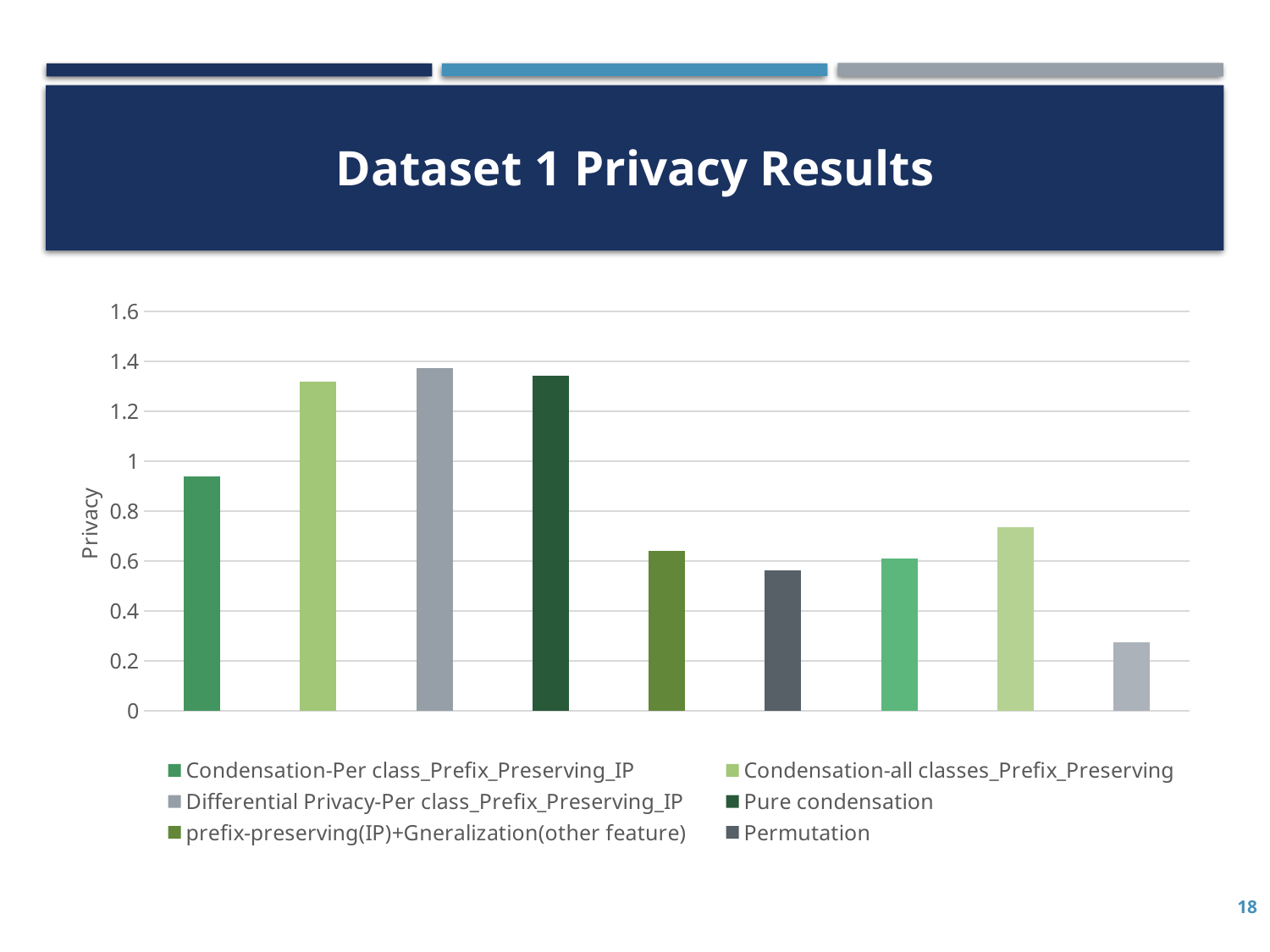
What is the title of the chart on the slide? Dataset 1 Privacy Results Which is larger, the Pure condensation bar or the Permutation bar? Pure condensation What is the label of the vertical axis? Privacy Is the value of the Permutation bar greater or less than 0.8? less How many series does the legend list? 6 Is the value of the rightmost bar greater or less than 0.4? less How many bars are plotted in the chart? 9 Which is larger, the second bar from the left or the first bar from the left? the second bar Which bar is the lowest in the chart? the last (rightmost) bar What kind of chart is shown on the slide? bar chart Is the value of the first bar from the left greater or less than 0.8? greater